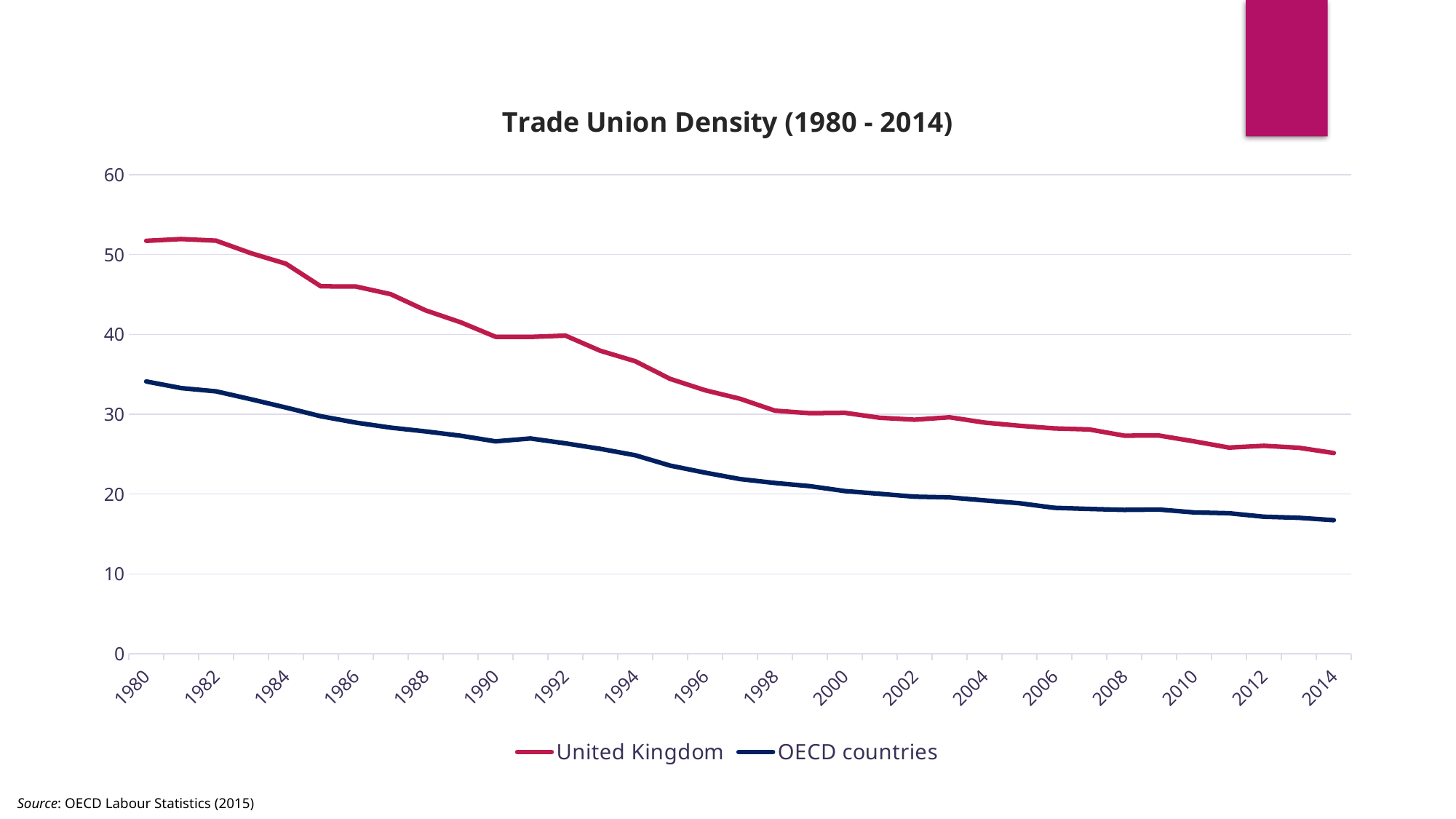
Is the value for United Kingdom in 2014 greater or less than 20? greater Is the value for OECD countries in 1980 greater or less than 30? greater Do the values for United Kingdom rise or fall from 1980 to 2014? fall Is the value for United Kingdom in 1986 greater or less than 40? greater How many series does the legend list? 2 Which series has the higher value in 1980, United Kingdom or OECD countries? United Kingdom What kind of chart is shown on the slide? line chart What is the title of the chart? Trade Union Density (1980 - 2014) Which series is drawn in dark blue? OECD countries